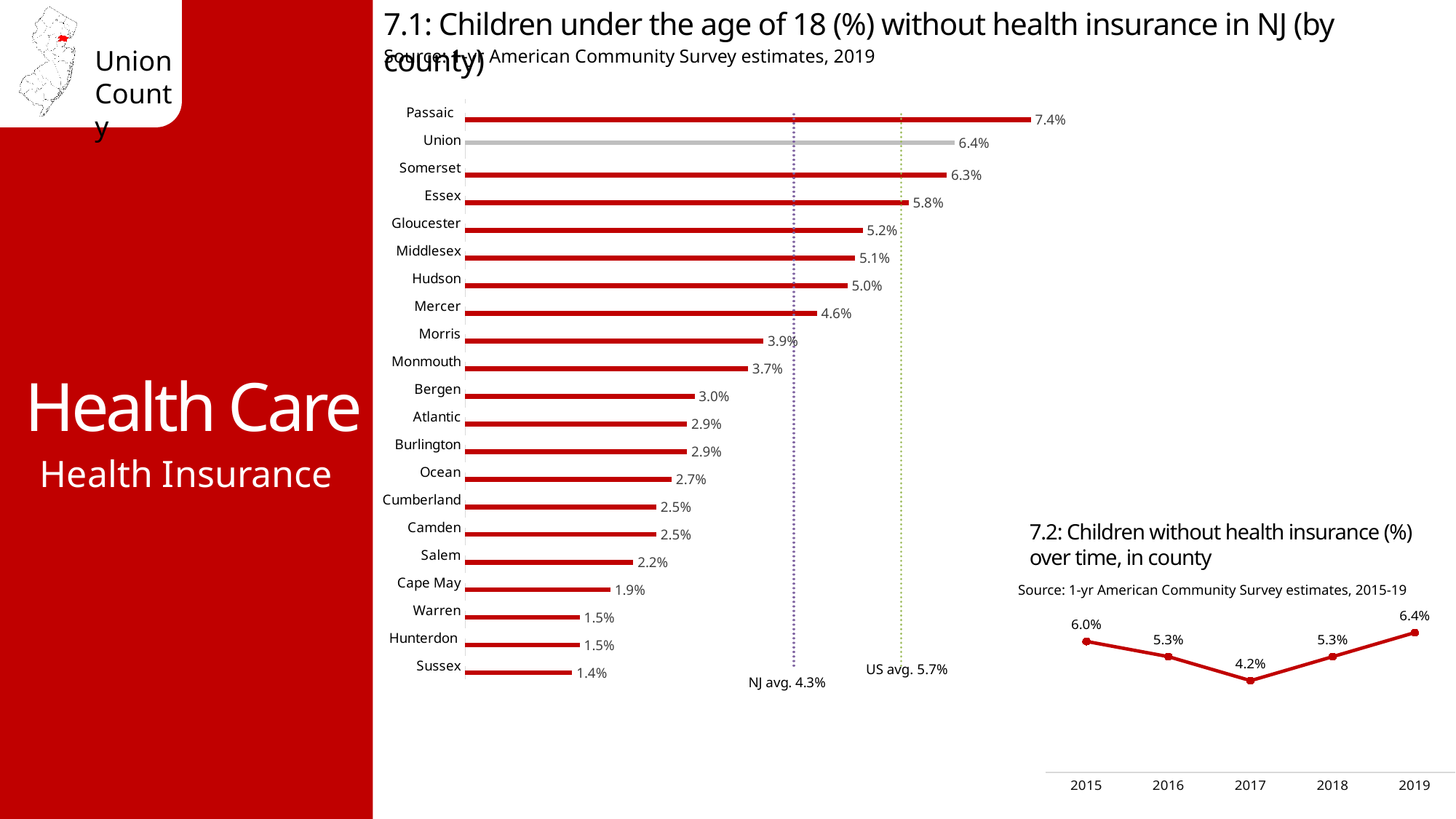
In chart 7.1, what is the value for Mercer? 4.6% In chart 7.1, how many counties are shown? 21 In chart 7.1, which county has the highest percentage of children without health insurance? Passaic In chart 7.2, what is the value for 2017? 4.2% In chart 7.1 (children under 18 without health insurance by county), what is the value for Union? 6.4% In chart 7.1, what NJ average is marked by the dotted reference line? 4.3% What kind of chart is chart 7.2 (children without health insurance over time)? Line chart In chart 7.1, which county has the lowest percentage of children without health insurance? Sussex In chart 7.2, which year has the highest value? 2019 In chart 7.1, which county has a higher value, Essex or Hudson? Essex In chart 7.1, what is the difference between the values for Passaic and Union? 1.0% In chart 7.2, what is the difference between the values for 2019 and 2017? 2.2%